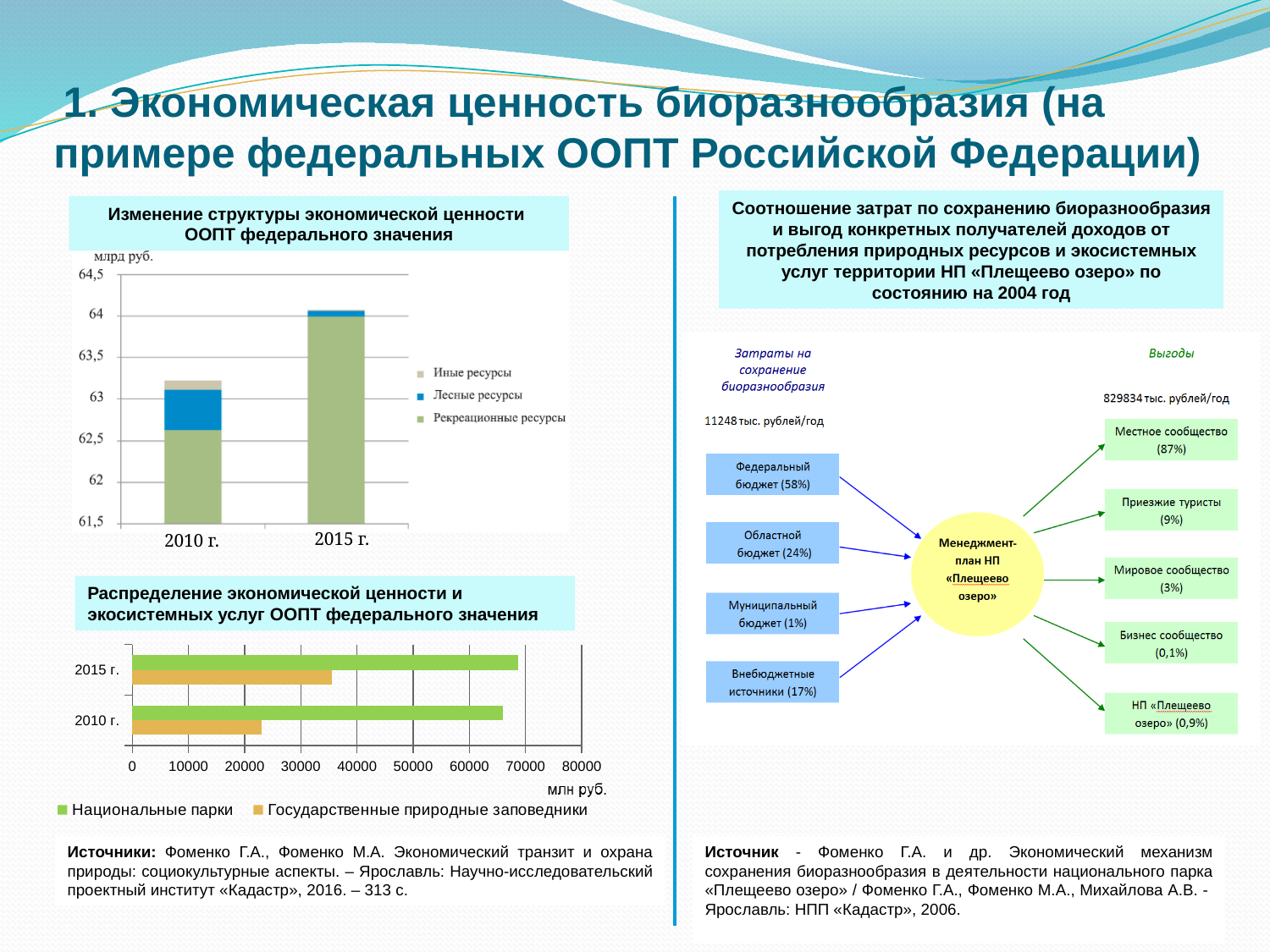
What unit is shown on the y axis of the chart «Изменение структуры экономической ценности ООПТ федерального значения»? млрд руб. In the chart «Распределение экономической ценности и экосистемных услуг ООПТ федерального значения», is the value for Государственные природные заповедники in 2010 г. greater or less than 30000? less How many years are shown on the x axis of the chart «Изменение структуры экономической ценности ООПТ федерального значения»? 2 How many series does the legend of the chart «Распределение экономической ценности и экосистемных услуг ООПТ федерального значения» list? 2 In the chart «Изменение структуры экономической ценности ООПТ федерального значения», which year has the higher total bar, 2010 г. or 2015 г.? 2015 г. What kind of chart is the chart titled «Распределение экономической ценности и экосистемных услуг ООПТ федерального значения»? bar chart In the chart «Распределение экономической ценности и экосистемных услуг ООПТ федерального значения», is the value for Национальные парки in 2015 г. greater or less than 60000? greater In the chart «Изменение структуры экономической ценности ООПТ федерального значения», is the total value for 2015 г. greater or less than 63.5? greater In the chart «Распределение экономической ценности и экосистемных услуг ООПТ федерального значения», which series has the larger value in 2015 г., Национальные парки or Государственные природные заповедники? Национальные парки How many series does the legend of the chart «Изменение структуры экономической ценности ООПТ федерального значения» list? 3 What kind of chart is the chart titled «Изменение структуры экономической ценности ООПТ федерального значения»? bar chart